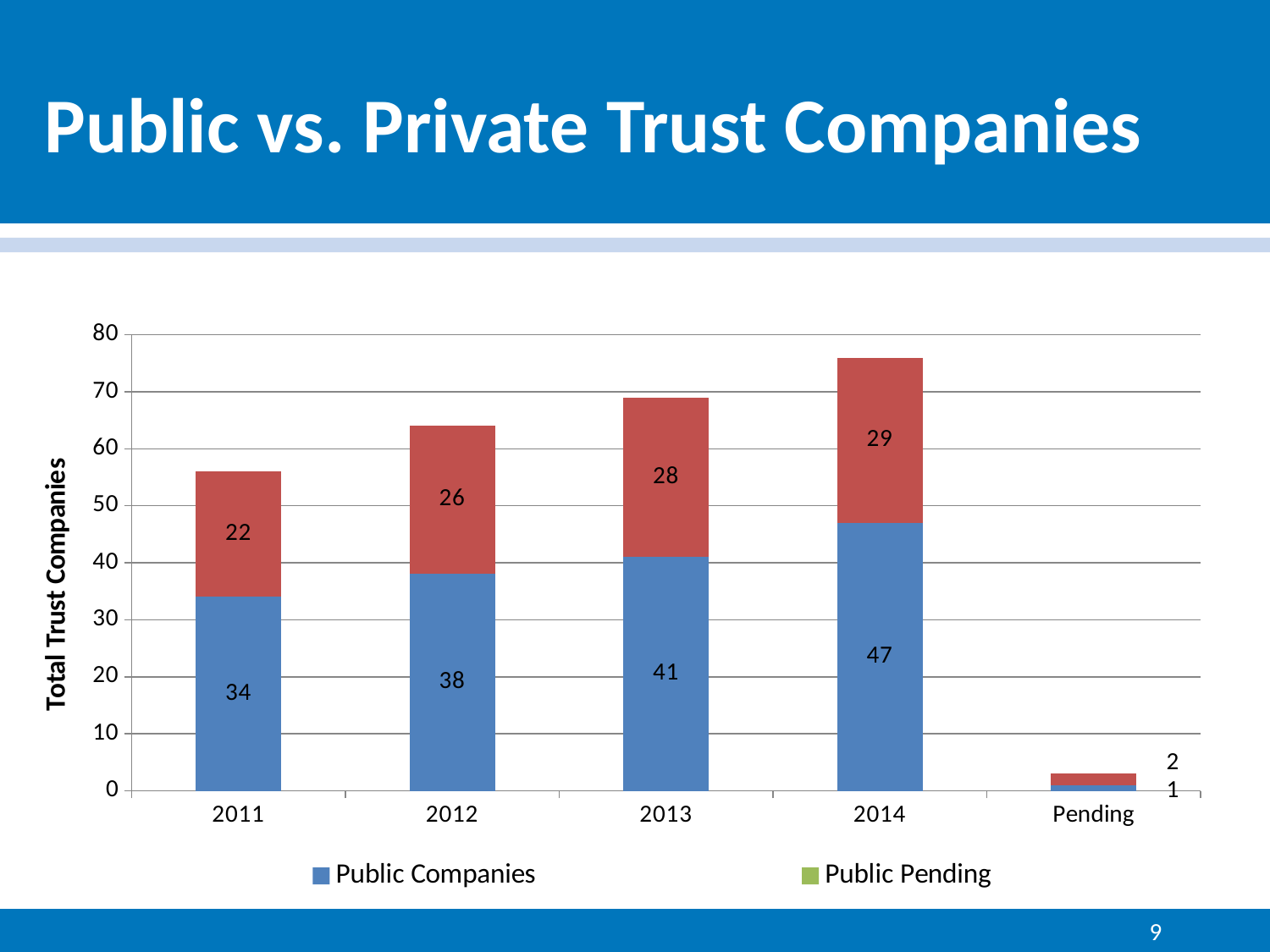
How many categories are shown on the x axis? 5 Which is larger, the Public Companies value for 2012 or for 2013? 2013 Do the Public Companies values rise or fall from 2011 to 2014? Rise What is the value of Public Companies for 2013? 41 What is the value of the red (upper) segment of the 2012 bar? 26 Which category has the lowest value for Public Companies? Pending What is the total of the stacked bar for 2011? 56 Which category has the highest value for Public Companies? 2014 How many series does the legend list? 2 What is the total of the stacked bar for 2014? 76 What kind of chart is shown on the slide? Stacked bar chart What is the difference between the Public Companies values for 2014 and 2011? 13